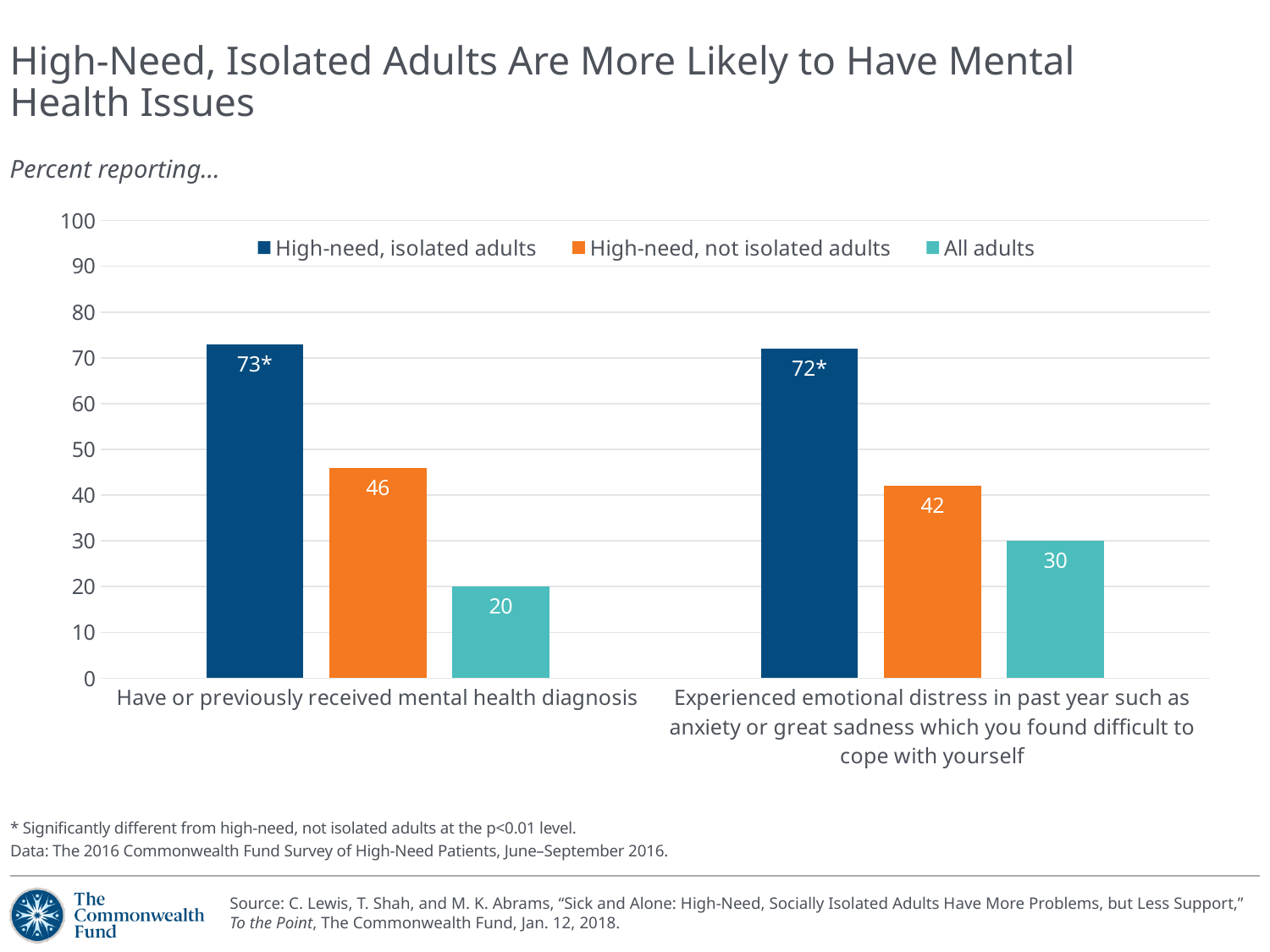
Which group has the lowest value for having or previously received a mental health diagnosis? All adults Which group has the highest value for experiencing emotional distress in the past year? High-need, isolated adults Which is larger: the value for high-need, not isolated adults for mental health diagnosis or for emotional distress? Mental health diagnosis (46) What is the difference between high-need, isolated adults and high-need, not isolated adults for experiencing emotional distress in the past year? 30 Which series is shown in orange in the legend? High-need, not isolated adults What percent of all adults experienced emotional distress in the past year? 30 What percent of high-need, not isolated adults have or previously received a mental health diagnosis? 46 How many series does the legend list? 3 How many categories are shown on the x axis? 2 What is the difference between high-need, isolated adults and all adults for having or previously received a mental health diagnosis? 53 What percent of high-need, isolated adults have or previously received a mental health diagnosis? 73* What kind of chart is shown on the slide? Bar chart